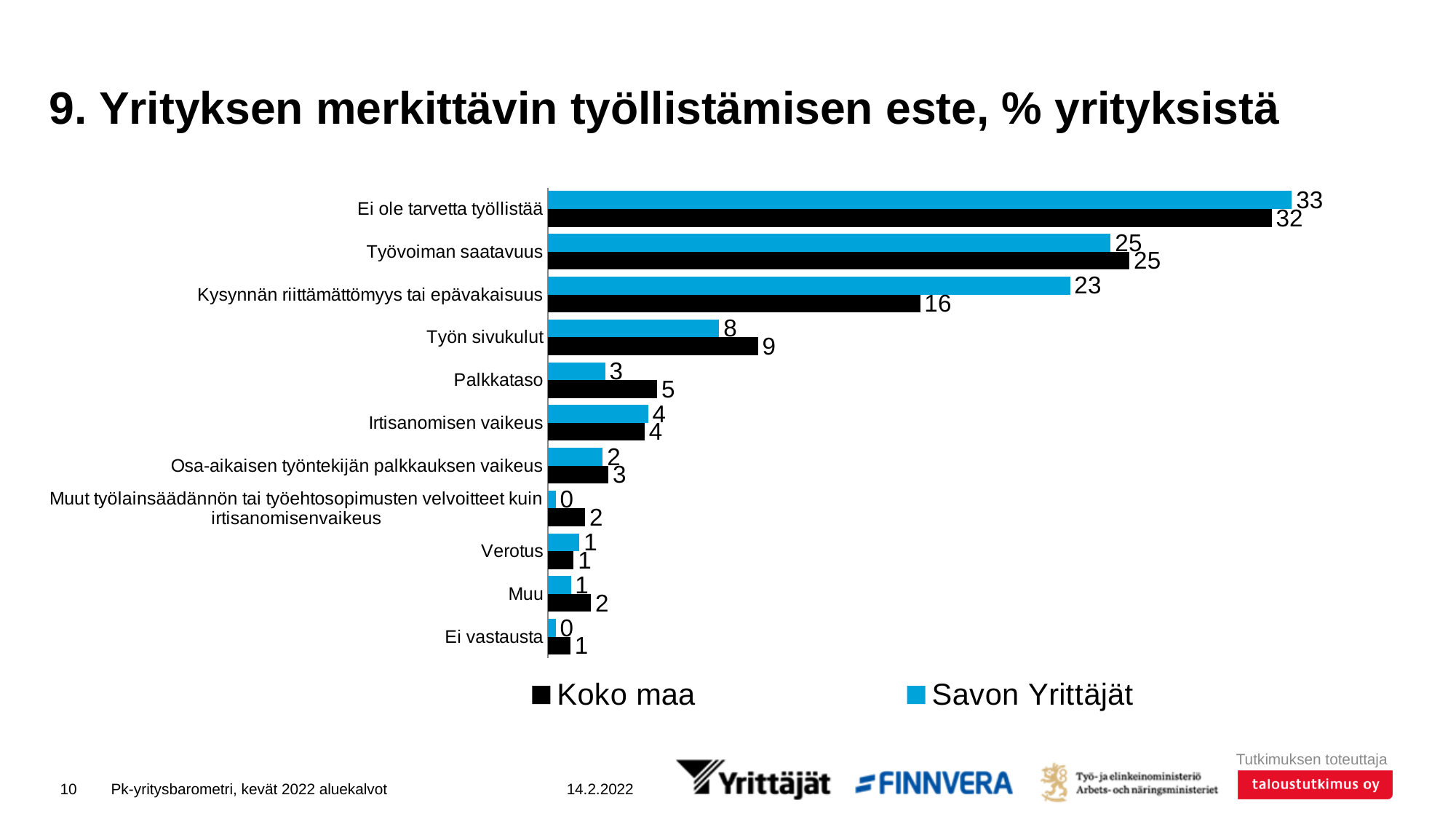
Which colour represents Savon Yrittäjät in the chart? Blue What is the value for Savon Yrittäjät for "Ei ole tarvetta työllistää"? 33 Which category has the highest value for Koko maa? Ei ole tarvetta työllistää How many categories are shown on the chart? 11 For "Kysynnän riittämättömyys tai epävakaisuus", which series has the larger value, Koko maa or Savon Yrittäjät? Savon Yrittäjät What kind of chart is shown on the slide? Bar chart What is the difference between the Savon Yrittäjät and Koko maa values for "Kysynnän riittämättömyys tai epävakaisuus"? 7 What is the value for Koko maa for "Kysynnän riittämättömyys tai epävakaisuus"? 16 How many series does the legend list? 2 For "Työn sivukulut", which series has the larger value, Koko maa or Savon Yrittäjät? Koko maa What is the difference between the Koko maa and Savon Yrittäjät values for "Palkkataso"? 2 What is the value for Koko maa for "Työn sivukulut"? 9